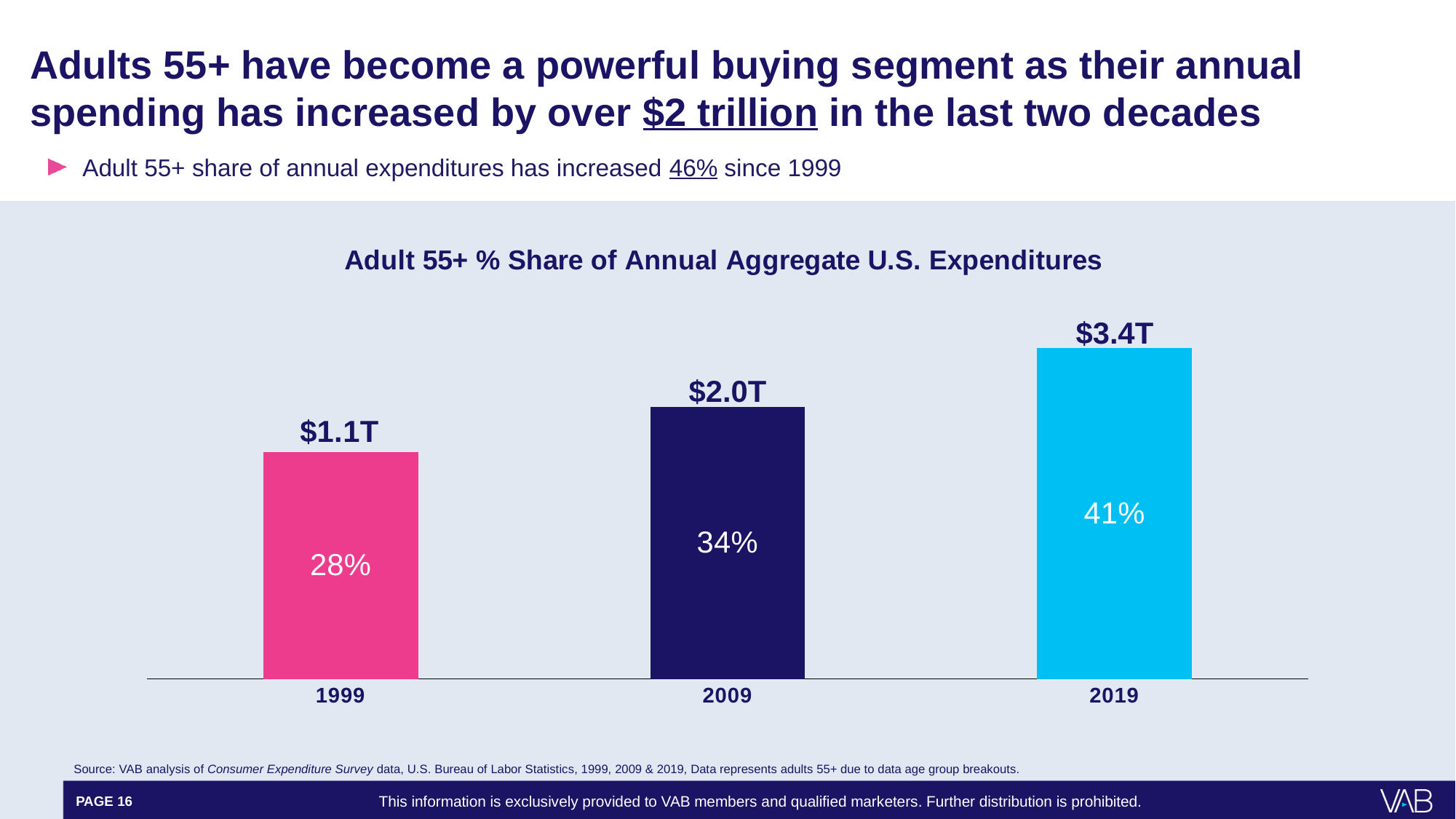
What type of chart is shown on the slide? Bar chart By how many percentage points did the Adult 55+ share of expenditures increase from 1999 to 2019? 13 percentage points How many years are shown on the chart? 3 What dollar amount is labelled above the 2019 bar? $3.4T What is the difference in dollar amount between the 2019 bar and the 1999 bar? $2.3T Do the values rise or fall from 1999 to 2019? Rise What dollar amount is labelled above the 2009 bar? $2.0T Which year has the highest Adult 55+ share of annual aggregate U.S. expenditures? 2019 Which year has a larger Adult 55+ share of expenditures, 1999 or 2009? 2009 Which year has the lowest Adult 55+ share of annual aggregate U.S. expenditures? 1999 What is the Adult 55+ share of annual aggregate U.S. expenditures in 2019? 41% What is the Adult 55+ share of annual aggregate U.S. expenditures in 1999? 28%